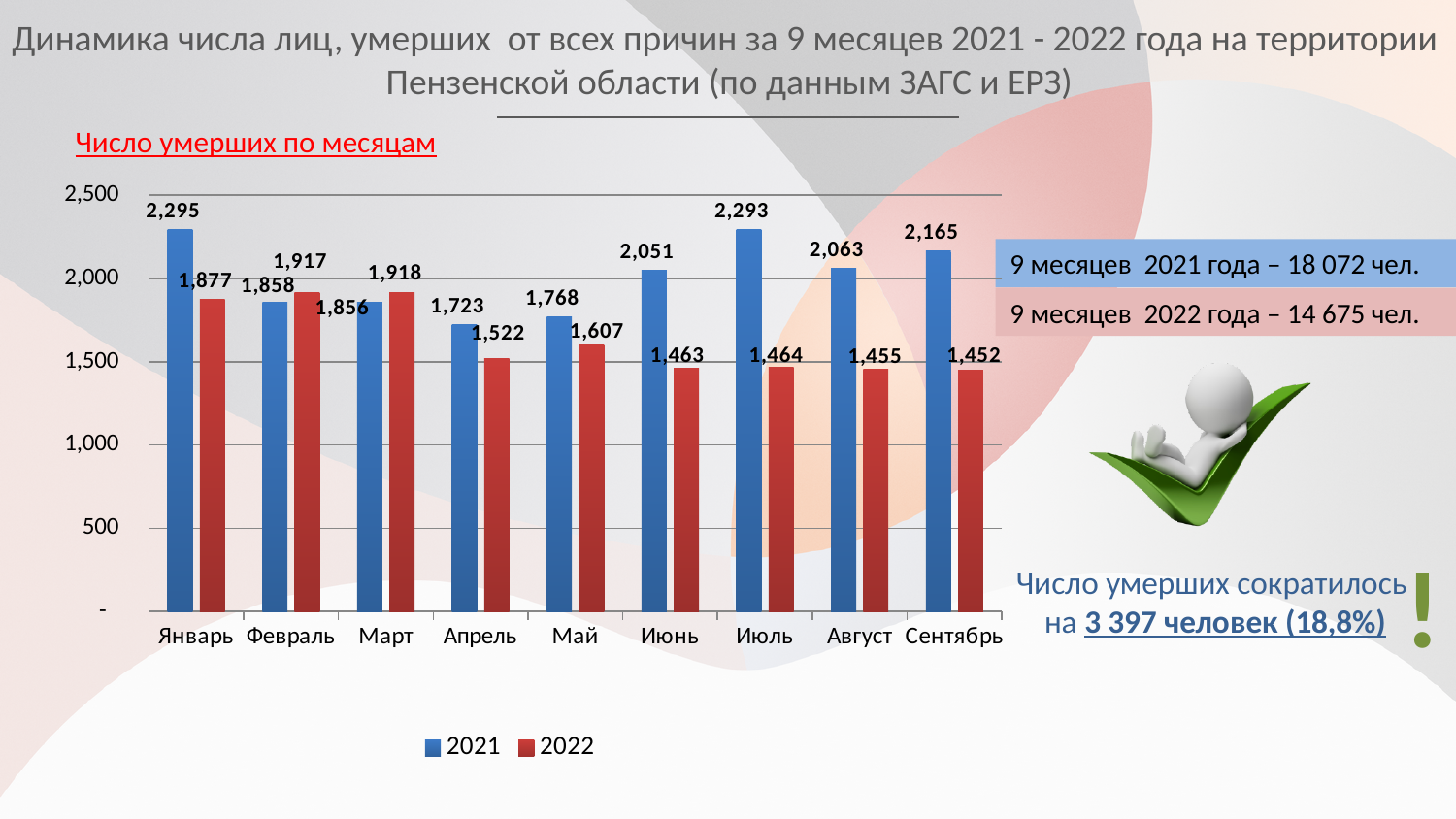
What is the value for 2021 in Май? 1,768 What is the difference between the 2021 and 2022 values in Январь? 418 In Февраль, which series has the larger value, 2021 or 2022? 2022 Do the 2021 values rise or fall from Апрель to Июль? rise Is the value for 2021 in Июль greater or less than 2,000? greater What is the value for 2022 in Июнь? 1,463 What is the difference between the 2021 and 2022 values in Сентябрь? 713 How many series does the legend list? 2 What is the value for 2022 in Сентябрь? 1,452 In which month is the 2021 value lowest? Апрель How many months are shown on the x axis? 9 What is the value for 2021 in Январь? 2,295